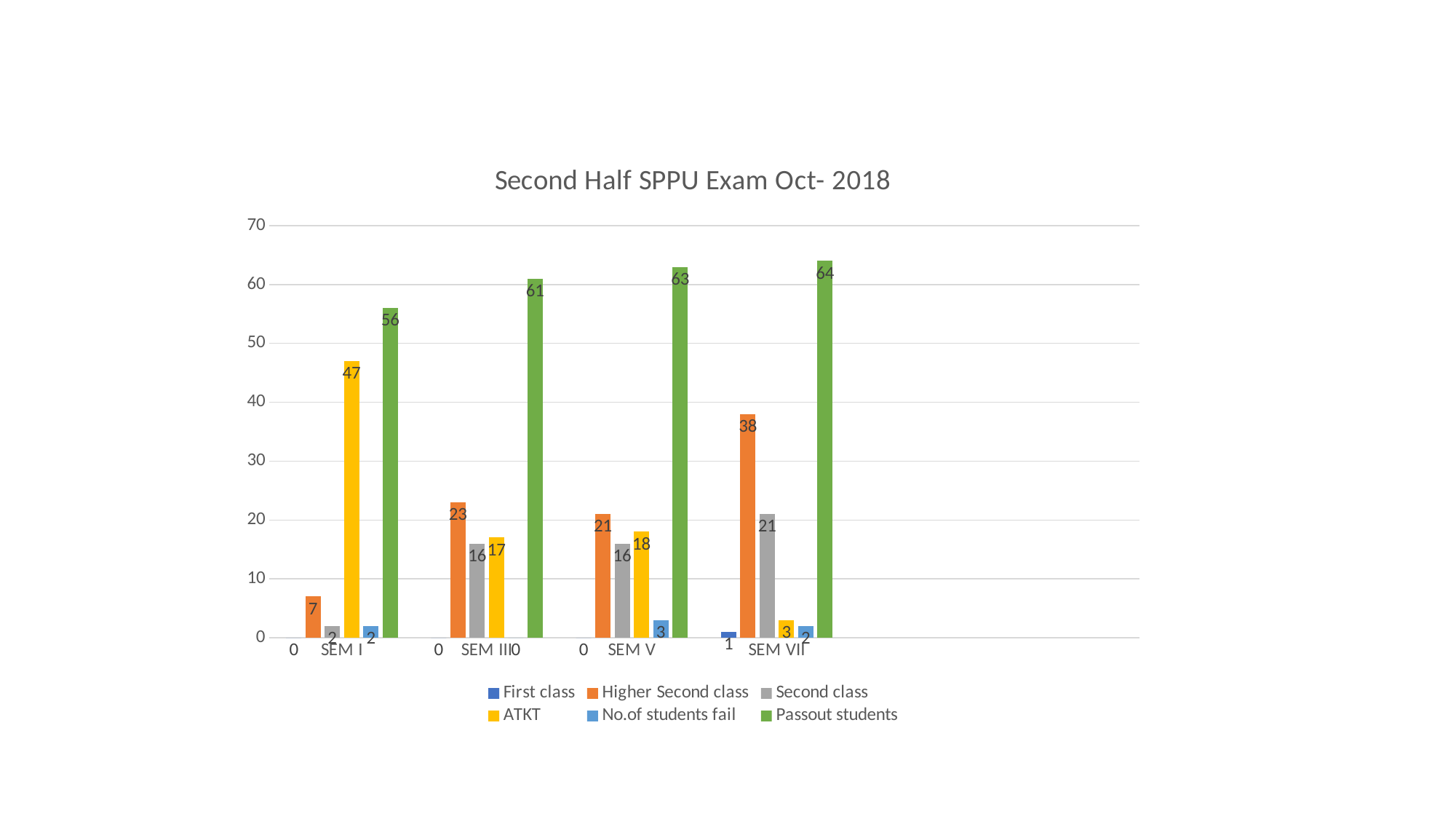
Which is larger, Higher Second class for SEM VII or Higher Second class for SEM V? Higher Second class for SEM VII Which semester has the lowest value for ATKT? SEM VII What is the value of Passout students for SEM VII? 64 How many series does the legend list? 6 What is the value of Higher Second class for SEM III? 23 What is the value of ATKT for SEM I? 47 How many semester categories are shown on the x axis? 4 Which semester has the highest value for Passout students? SEM VII What kind of chart is shown on the slide? bar chart What is the title of the chart? Second Half SPPU Exam Oct- 2018 Do the Passout students values rise or fall from SEM I to SEM VII? rise What is the difference between Passout students for SEM VII and SEM I? 8